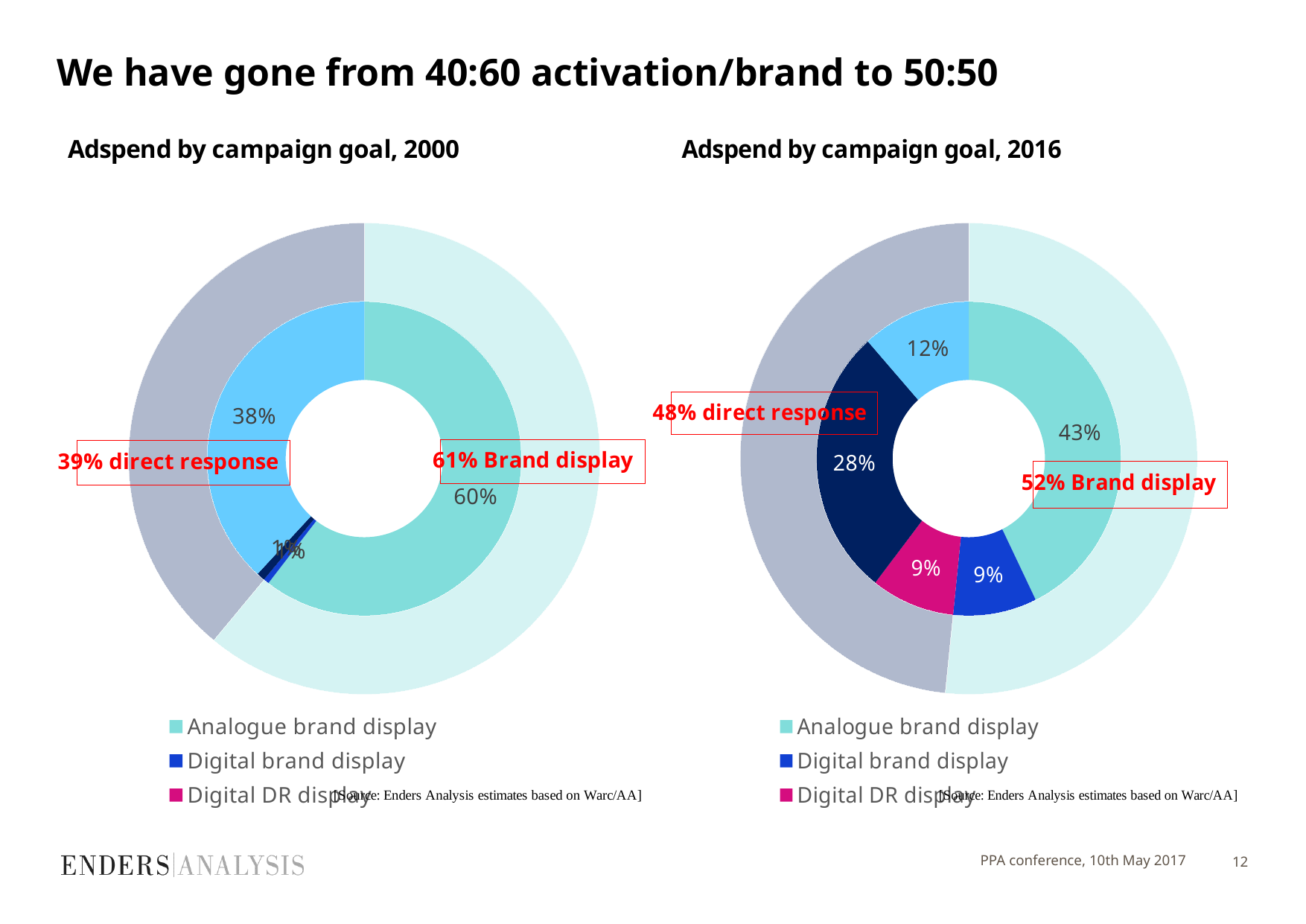
What kind of chart is used on this slide? Doughnut (pie) chart In the 'Adspend by campaign goal, 2000' chart, what share of adspend is annotated as direct response? 39% In the 'Adspend by campaign goal, 2016' chart, what share of adspend is annotated as Brand display? 52% In the 'Adspend by campaign goal, 2016' chart, what share is labelled for Digital DR display? 9% In the 'Adspend by campaign goal, 2000' chart, what share is labelled for Analogue brand display in the inner ring? 60% In the 'Adspend by campaign goal, 2000' chart, what share of adspend is annotated as Brand display? 61% In the 'Adspend by campaign goal, 2016' chart, what share is labelled for Analogue brand display in the inner ring? 43% In the 'Adspend by campaign goal, 2016' chart, what share of adspend is annotated as direct response? 48% In the 'Adspend by campaign goal, 2016' chart, what share is labelled for Digital brand display? 9% In the 'Adspend by campaign goal, 2016' chart, which labelled inner-ring segment is the largest? Analogue brand display (43%) In the 'Adspend by campaign goal, 2016' chart, which is larger, the Brand display share or the direct response share? Brand display By how many percentage points did the Analogue brand display share fall from the 2000 chart to the 2016 chart? 17 percentage points